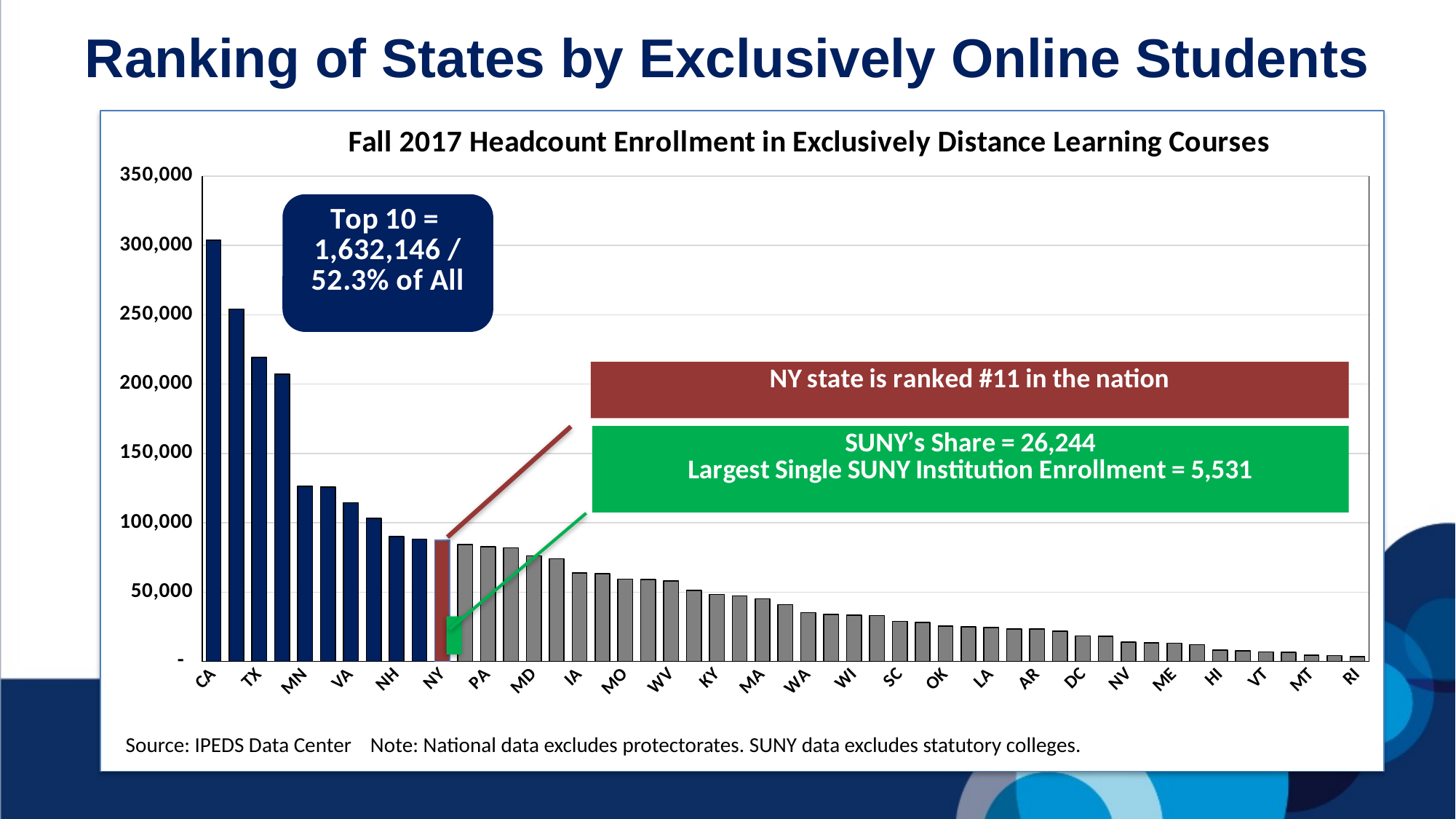
Is the value for NY greater or less than 100,000? less Is the value for TX greater or less than 300,000? less According to the annotation on the chart, what rank does NY state hold in the nation? #11 Is the value for CA greater or less than 250,000? greater Which state has the highest Fall 2017 headcount enrollment in exclusively distance learning courses? CA Do the enrollment values rise or fall moving from left to right along the x axis? fall Which has a larger enrollment, MN or VA? MN What kind of chart is shown on the slide? bar chart Which has a larger enrollment, CA or TX? CA